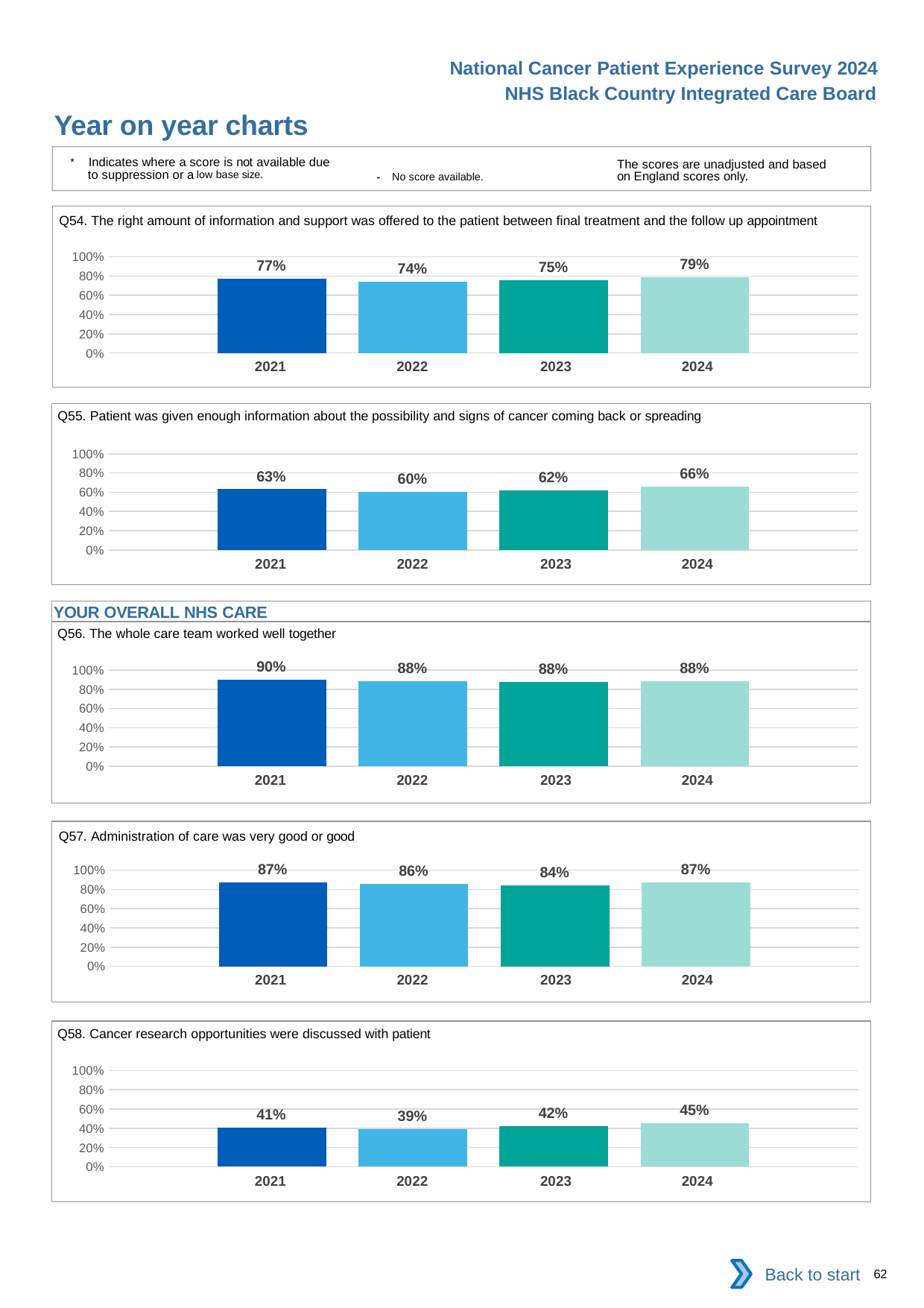
What kind of chart is the Q54 chart? Bar chart In the Q56 chart, is the value for 2023 greater or less than 80%? greater How many years are shown in the Q58 chart? 4 In the Q54 chart, what is the value for 2024? 79% In the Q58 chart, what is the difference between the 2024 and 2021 values? 4% In the Q55 chart, which year has the highest value? 2024 In the Q56 chart, what is the value for 2021? 90% In the Q58 chart, what is the value for 2022? 39% In the Q57 chart, what is the value for 2023? 84% In the Q54 chart, which year has the lowest value? 2022 In the Q55 chart, what is the difference between the 2024 and 2022 values? 6% In the Q57 chart, which is larger, the value for 2022 or the value for 2023? 2022